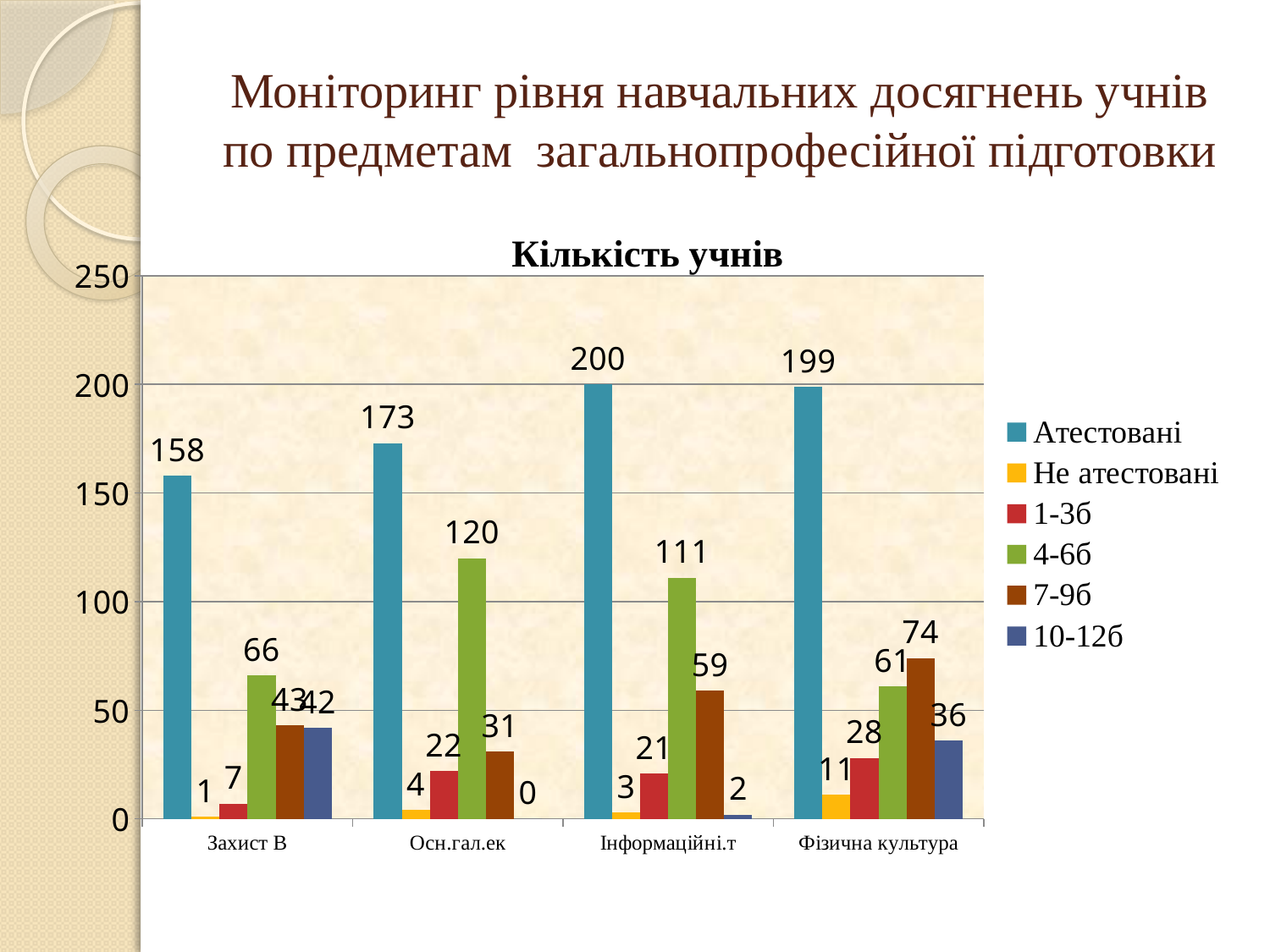
Which is larger: the 7-9б value for Інформаційні.т or the 7-9б value for Фізична культура? Фізична культура How many series does the legend list? 6 Is the Атестовані value for Захист В greater or less than 150? greater Which category has the lowest 4-6б value? Фізична культура What type of chart is shown? bar chart Which category has the highest Атестовані value? Інформаційні.т What is the value of Атестовані for Інформаційні.т? 200 What is the value of 4-6б for Осн.гал.ек? 120 What is the value of 7-9б for Фізична культура? 74 What is the value of Не атестовані for Фізична культура? 11 What is the difference between the Атестовані values for Осн.гал.ек and Захист В? 15 How many categories are shown on the x axis? 4